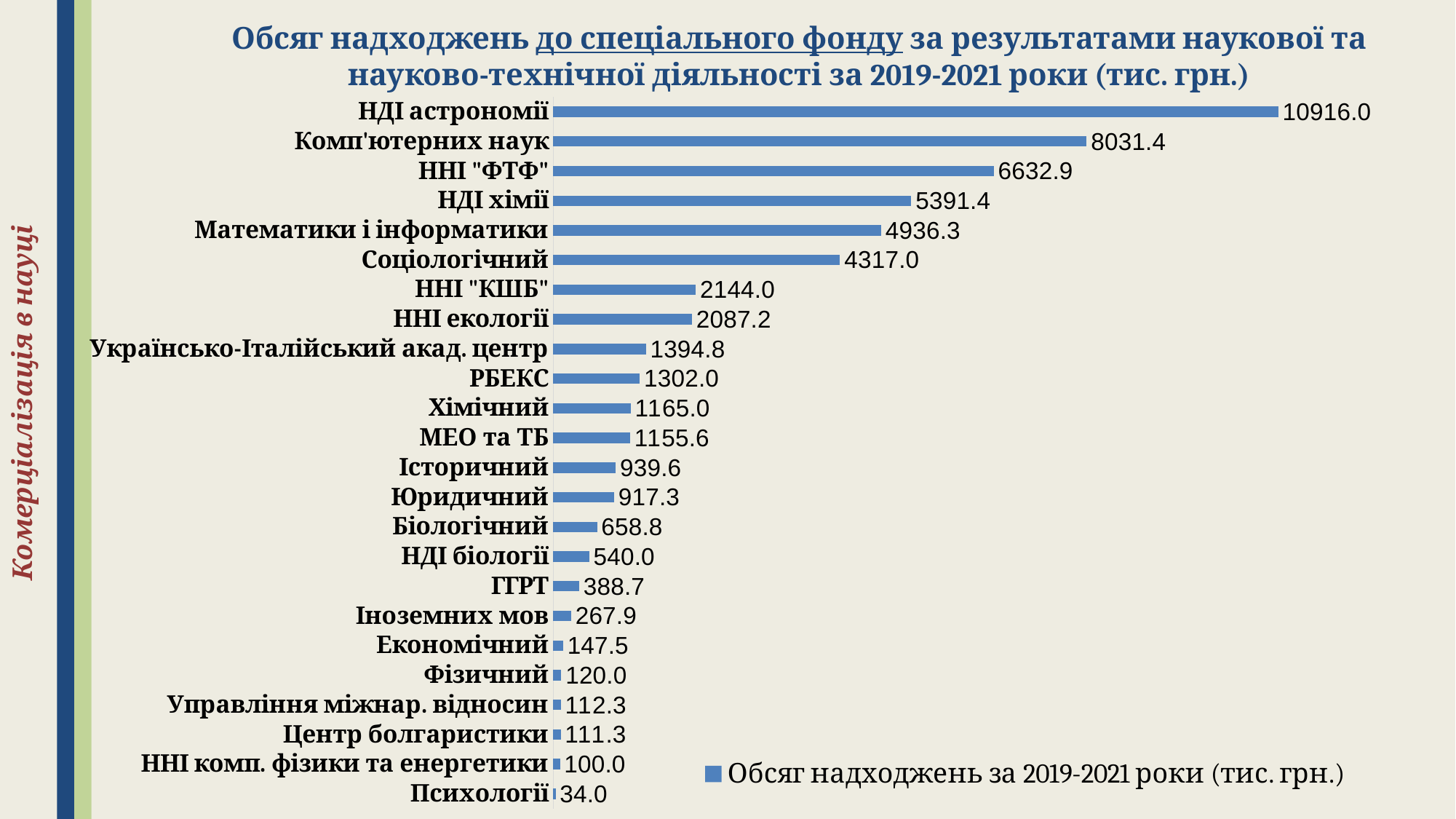
Which category has the highest value? НДІ астрономії What is the value for Соціологічний? 4317.0 What is the difference between the values for ННІ "КШБ" and ННІ екології? 56.8 What is the value for Психології? 34.0 What is the difference between the values for НДІ астрономії and Комп'ютерних наук? 2884.6 What is the value for НДІ астрономії? 10916.0 What is the value for Українсько-Італійський акад. центр? 1394.8 Which is larger, the value for НДІ хімії or the value for Математики і інформатики? НДІ хімії How many categories are shown in the chart? 24 What kind of chart is shown on the slide? Bar chart What is the legend entry of the chart? Обсяг надходжень за 2019-2021 роки (тис. грн.) Which category has the lowest value? Психології